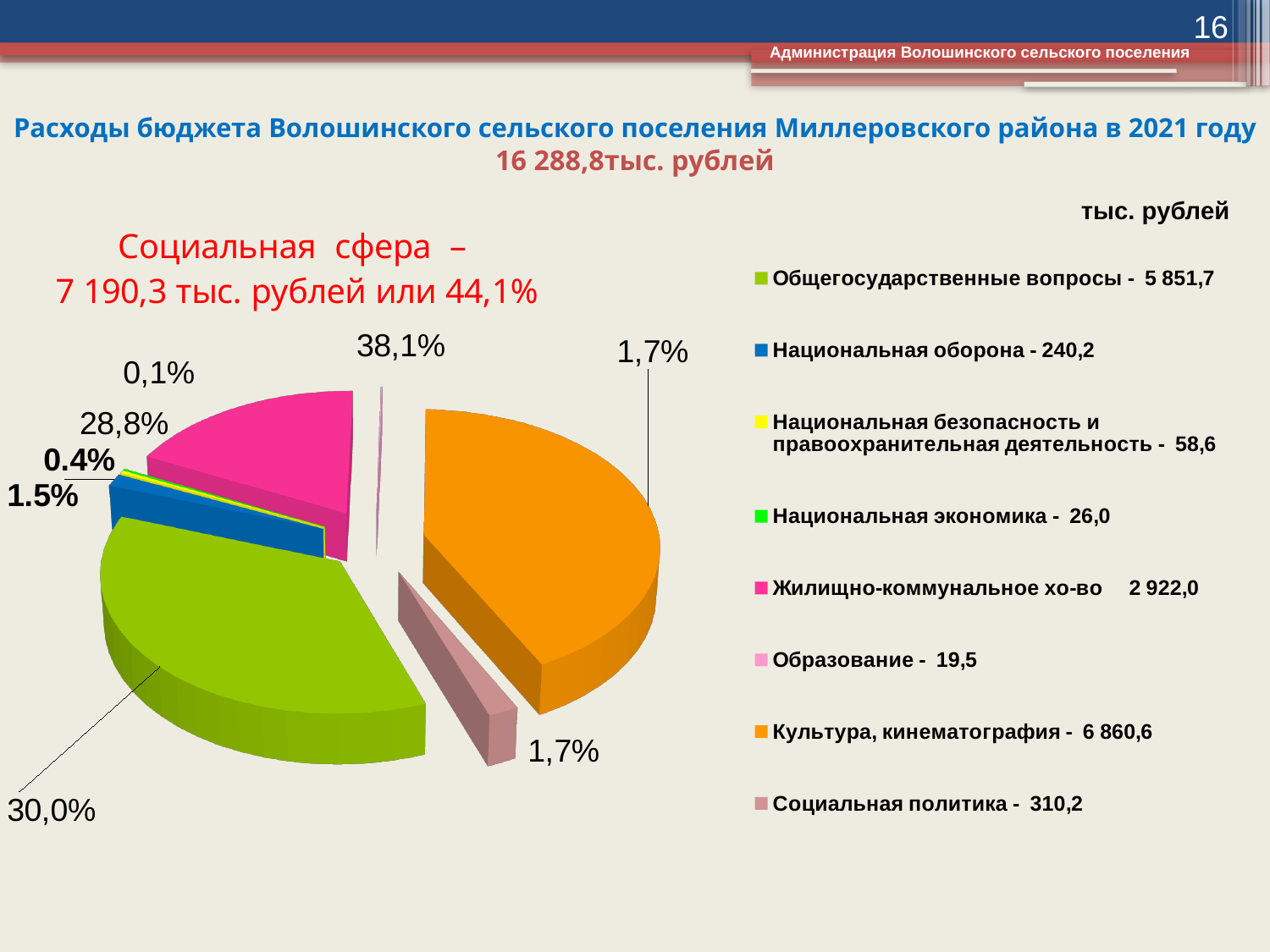
How many categories does the legend list? 8 What is the difference between the values for Культура, кинематография and Общегосударственные вопросы? 1 008,9 What kind of chart is shown on the slide? pie chart Which category has the highest value in the legend? Культура, кинематография What is the value for Жилищно-коммунальное хо-во? 2 922,0 Which is larger: the value for Национальная оборона or the value for Социальная политика? Социальная политика Which category has the lowest value in the legend? Образование What is the value for Культура, кинематография? 6 860,6 What is the value for Общегосударственные вопросы? 5 851,7 What is the value for Образование? 19,5 What total budget expenditure is stated in the slide title? 16 288,8тыс. рублей